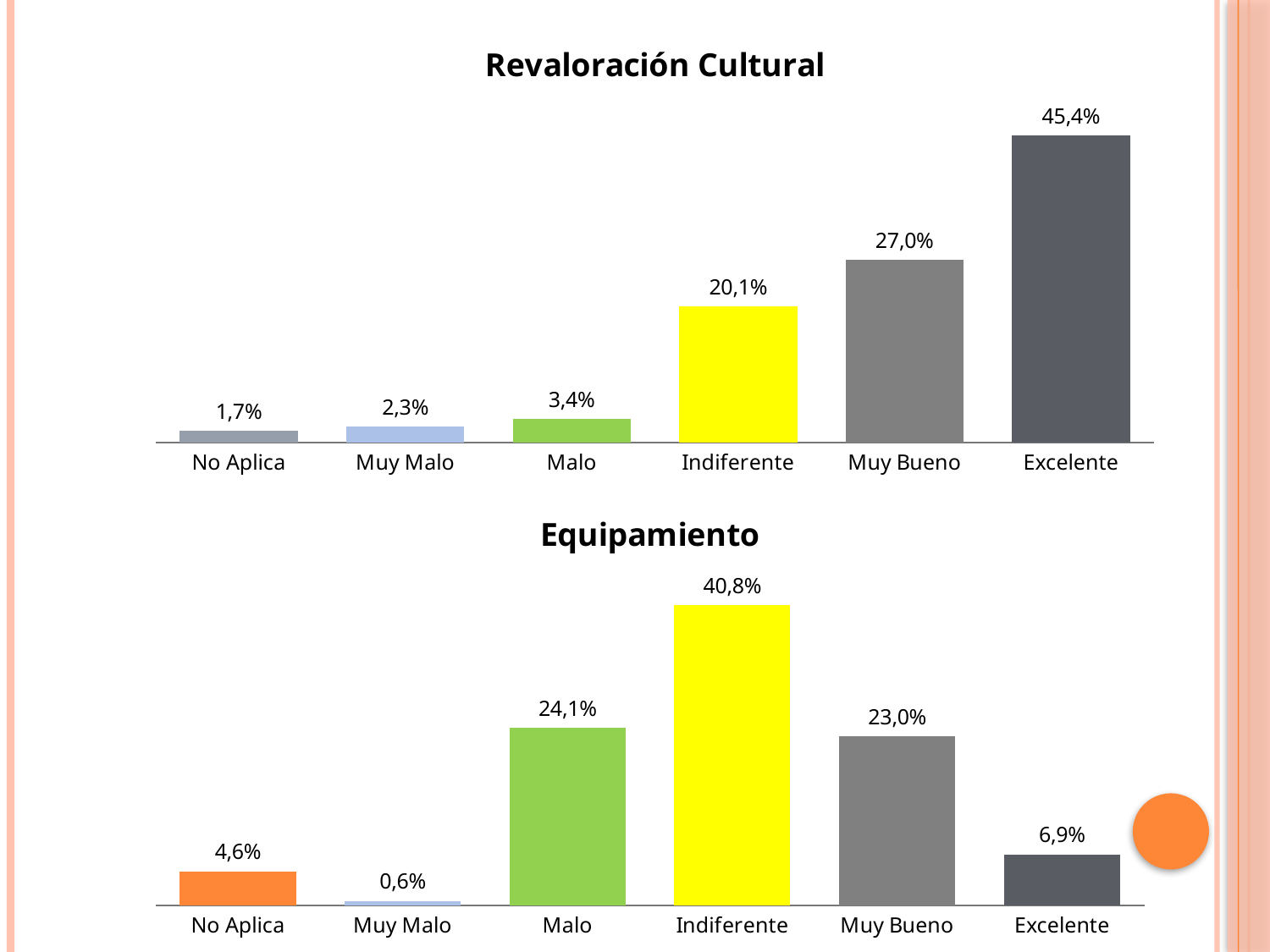
In the 'Equipamiento' chart, which is larger, Muy Bueno or Excelente? Muy Bueno In the 'Revaloración Cultural' chart, do the values rise or fall from left to right along the x axis? rise In the 'Revaloración Cultural' chart, which category has the lowest value? No Aplica In the 'Revaloración Cultural' chart, what is the value for Indiferente? 20,1% What type of chart is the 'Revaloración Cultural' chart? bar chart In the 'Revaloración Cultural' chart, what is the difference between Excelente and Muy Bueno? 18,4% In the 'Revaloración Cultural' chart, what is the value for Excelente? 45,4% How many categories are shown in the 'Equipamiento' chart? 6 In the 'Equipamiento' chart, which category has the lowest value? Muy Malo In the 'Equipamiento' chart, what is the difference between Indiferente and Muy Bueno? 17,8% In the 'Equipamiento' chart, which category has the highest value? Indiferente In the 'Equipamiento' chart, what is the value for Malo? 24,1%